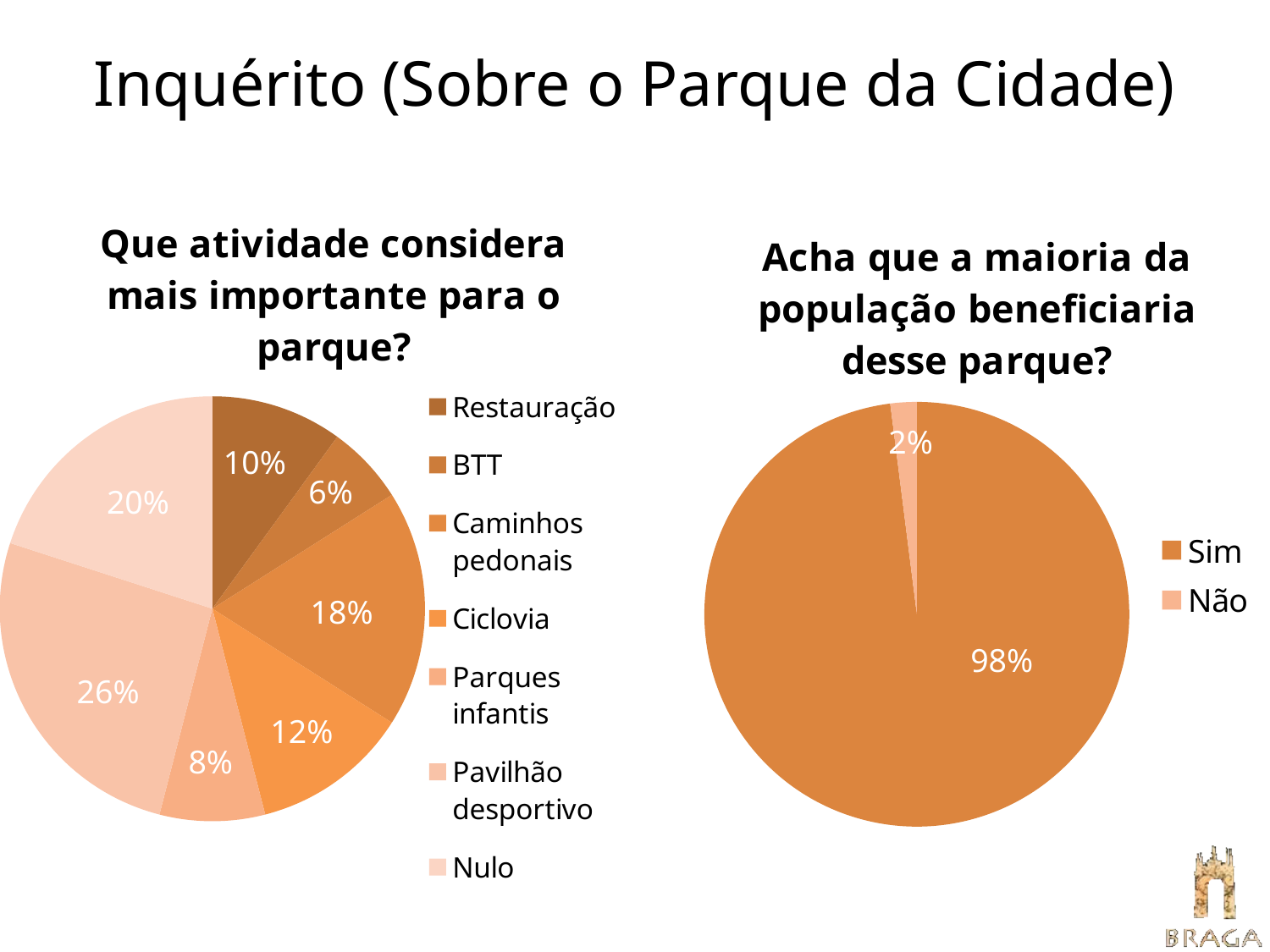
In the chart titled "Que atividade considera mais importante para o parque?", what is the difference in percentage points between Pavilhão desportivo and Nulo? 6 In the chart titled "Que atividade considera mais importante para o parque?", which is larger, Restauração or Parques infantis? Restauração How many categories does the legend of the chart titled "Que atividade considera mais importante para o parque?" list? 7 In the chart titled "Que atividade considera mais importante para o parque?", what percentage is shown for Ciclovia? 12% In the chart titled "Acha que a maioria da população beneficiaria desse parque?", what percentage answered Não? 2% In the chart titled "Acha que a maioria da população beneficiaria desse parque?", what percentage answered Sim? 98% What type of chart is the chart titled "Que atividade considera mais importante para o parque?"? Pie chart In the chart titled "Que atividade considera mais importante para o parque?", what percentage is shown for BTT? 6% How many entries does the legend of the chart titled "Acha que a maioria da população beneficiaria desse parque?" list? 2 In the chart titled "Que atividade considera mais importante para o parque?", which category has the largest slice? Pavilhão desportivo In the chart titled "Que atividade considera mais importante para o parque?", what percentage is shown for Caminhos pedonais? 18% In the chart titled "Que atividade considera mais importante para o parque?", which category has the smallest slice? BTT